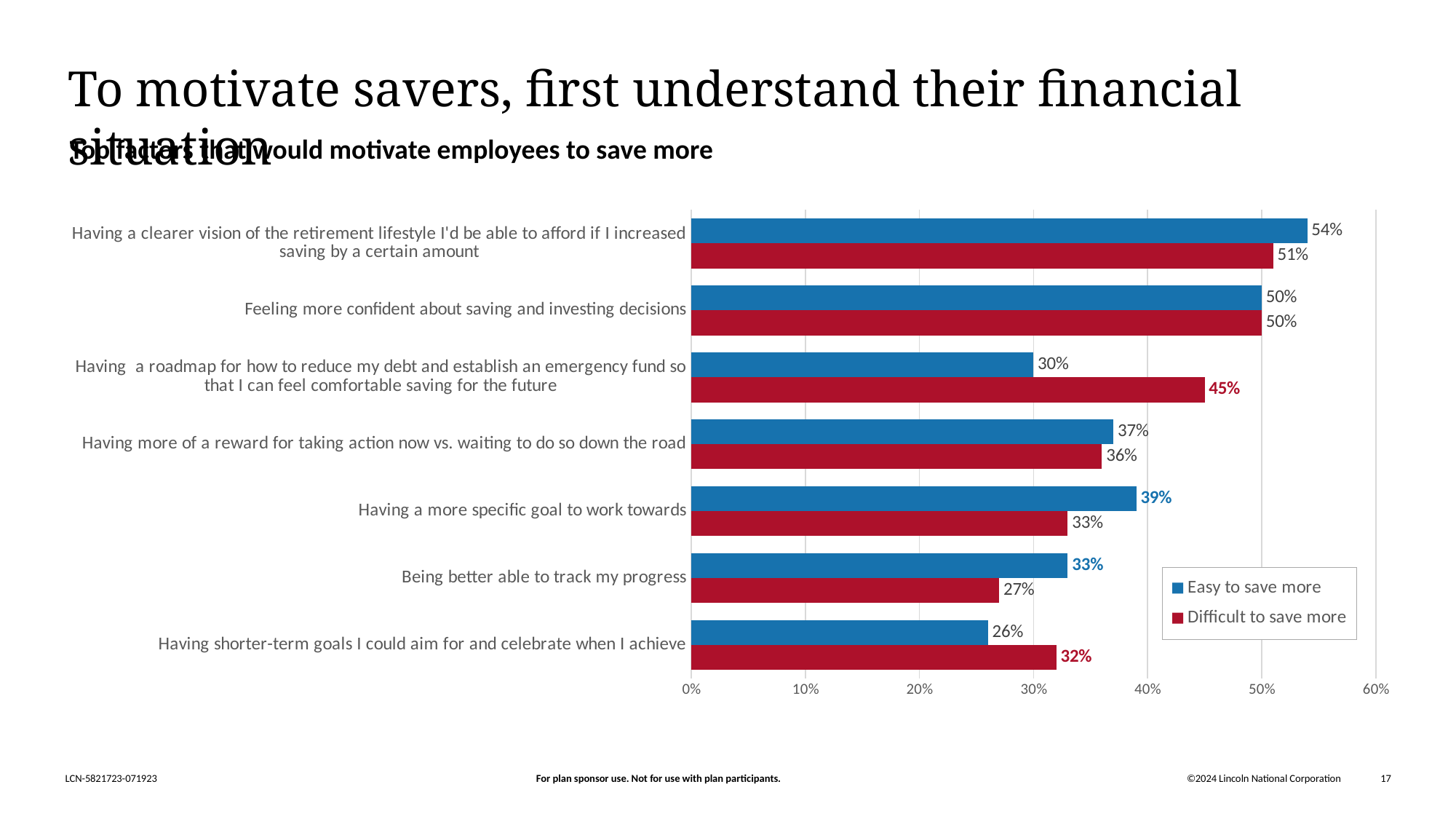
What is the value for "Easy to save more" for "Having a clearer vision of the retirement lifestyle I'd be able to afford if I increased saving by a certain amount"? 54% What is the value for "Difficult to save more" for "Having a roadmap for how to reduce my debt and establish an emergency fund so that I can feel comfortable saving for the future"? 45% What kind of chart is shown on the slide? Bar chart Which category has the highest value for "Easy to save more"? Having a clearer vision of the retirement lifestyle I'd be able to afford if I increased saving by a certain amount How many categories are shown on the chart? 7 What colour are the bars for the "Difficult to save more" series? Red What is the value for "Easy to save more" for "Having a more specific goal to work towards"? 39% What is the value for "Difficult to save more" for "Being better able to track my progress"? 27% How many series does the legend list? 2 What is the difference between the "Difficult to save more" and "Easy to save more" values for "Having a roadmap for how to reduce my debt and establish an emergency fund so that I can feel comfortable saving for the future"? 15% Which category has the lowest value for "Easy to save more"? Having shorter-term goals I could aim for and celebrate when I achieve For "Having shorter-term goals I could aim for and celebrate when I achieve", which is larger: "Easy to save more" or "Difficult to save more"? Difficult to save more